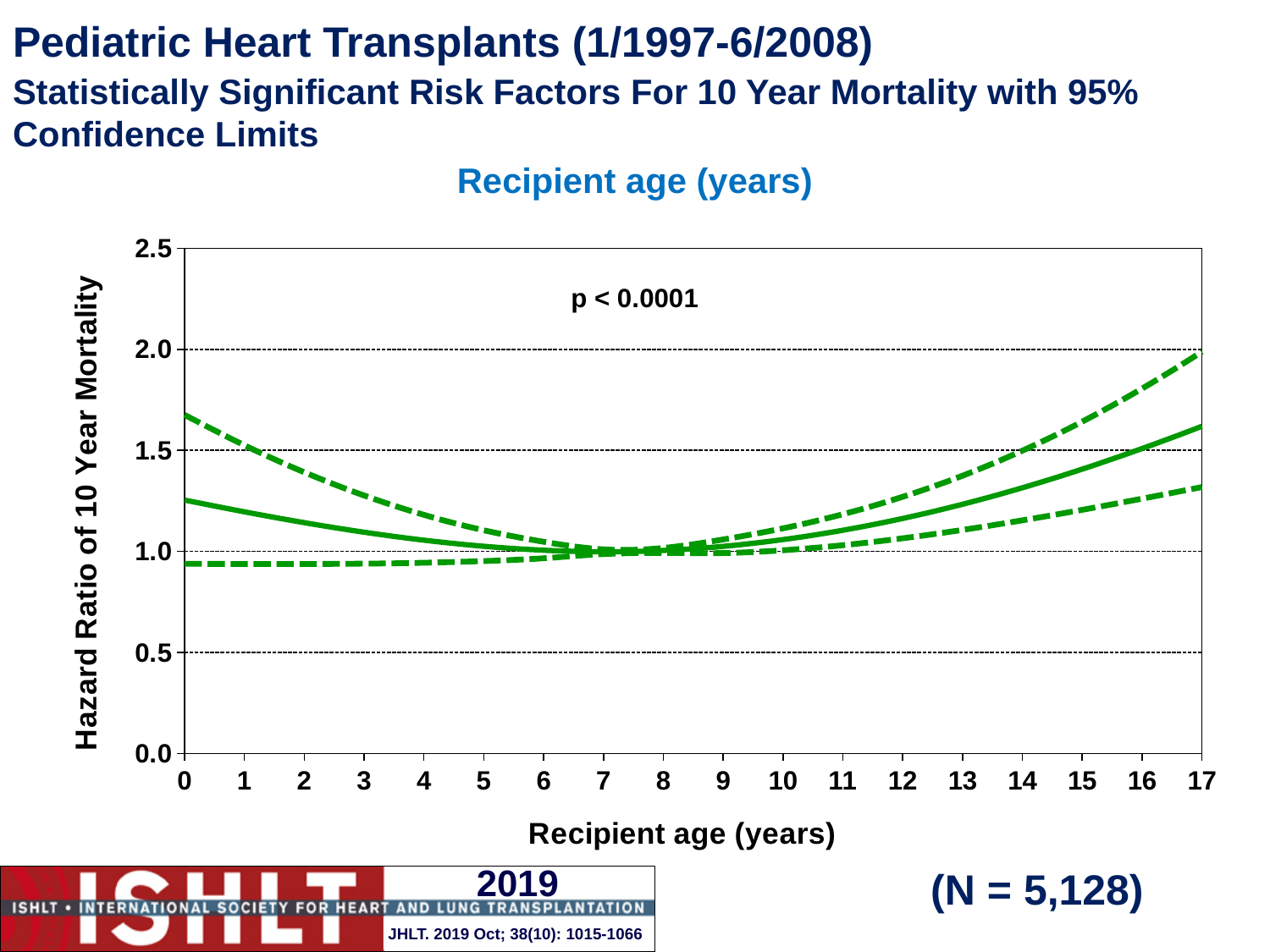
Is the hazard ratio (solid line) at recipient age 0 greater or less than 1.0? greater Does the hazard ratio (solid line) rise or fall as recipient age increases from 9 to 17 years? rise Is the lower confidence limit (lower dashed line) at recipient age 0 greater or less than 1.0? less Is the upper confidence limit (upper dashed line) at recipient age 0 greater or less than 1.5? greater Does the hazard ratio (solid line) rise or fall as recipient age increases from 0 to 6 years? fall What p-value is printed on the chart? p < 0.0001 What kind of chart is shown on the slide? line chart Which recipient age has the higher hazard ratio on the solid line, 0 years or 17 years? 17 years How many lines are plotted on the chart? 3 What is the label of the y axis? Hazard Ratio of 10 Year Mortality